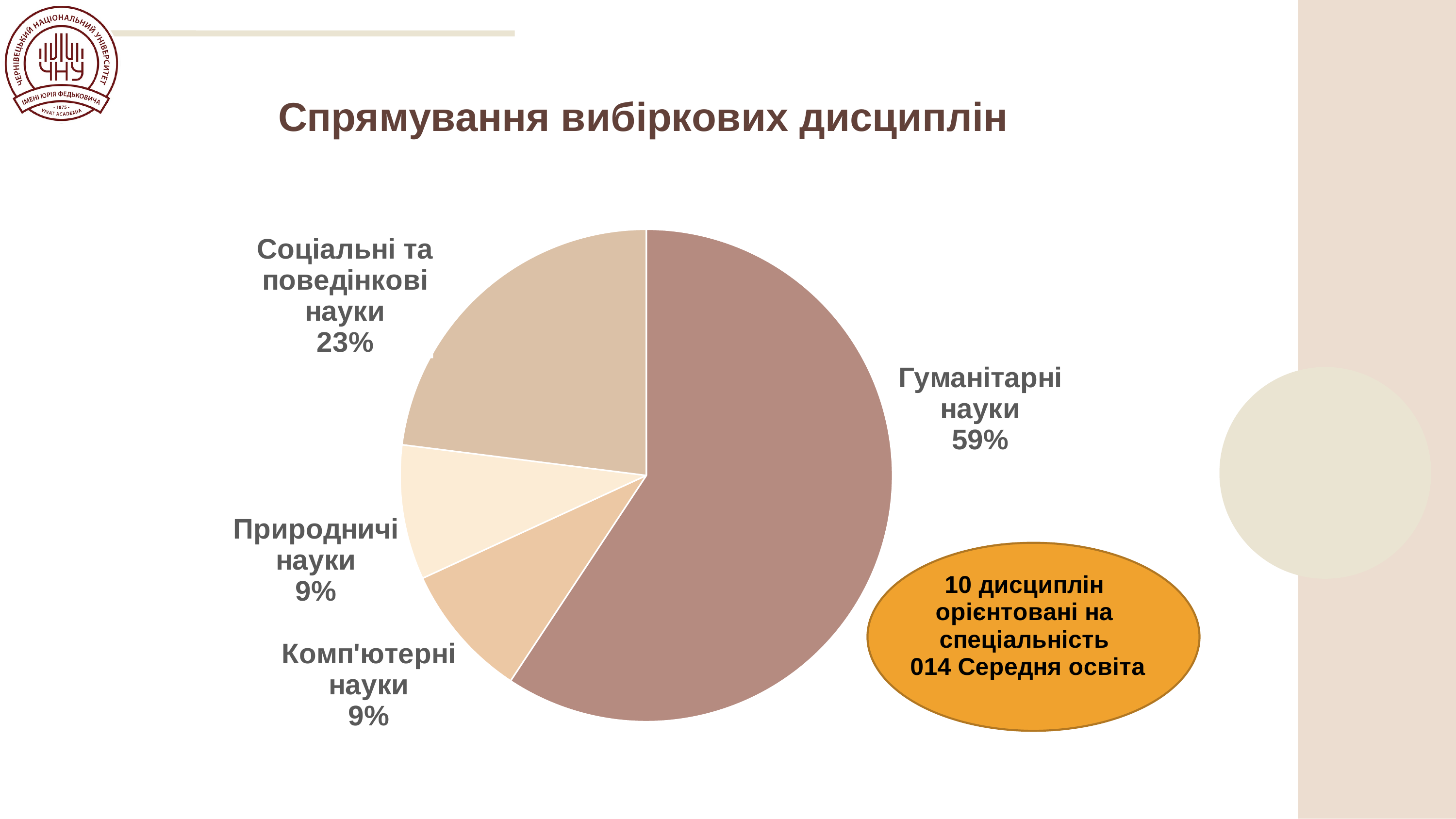
What is the difference in percentage points between Гуманітарні науки and Соціальні та поведінкові науки? 36 Which is larger, the slice for Соціальні та поведінкові науки or the slice for Природничі науки? Соціальні та поведінкові науки What is the value shown for Соціальні та поведінкові науки? 23% What share of the pie does Гуманітарні науки take? 59% How many slices does the pie chart have? 4 What is the title of the chart on the slide? Спрямування вибіркових дисциплін Which category has the largest slice of the pie? Гуманітарні науки What is the value shown for Комп'ютерні науки? 9% What kind of chart is shown on the slide? pie chart Which is larger, the slice for Гуманітарні науки or the slice for Соціальні та поведінкові науки? Гуманітарні науки What is the value shown for Природничі науки? 9% What is the difference in percentage points between Соціальні та поведінкові науки and Комп'ютерні науки? 14